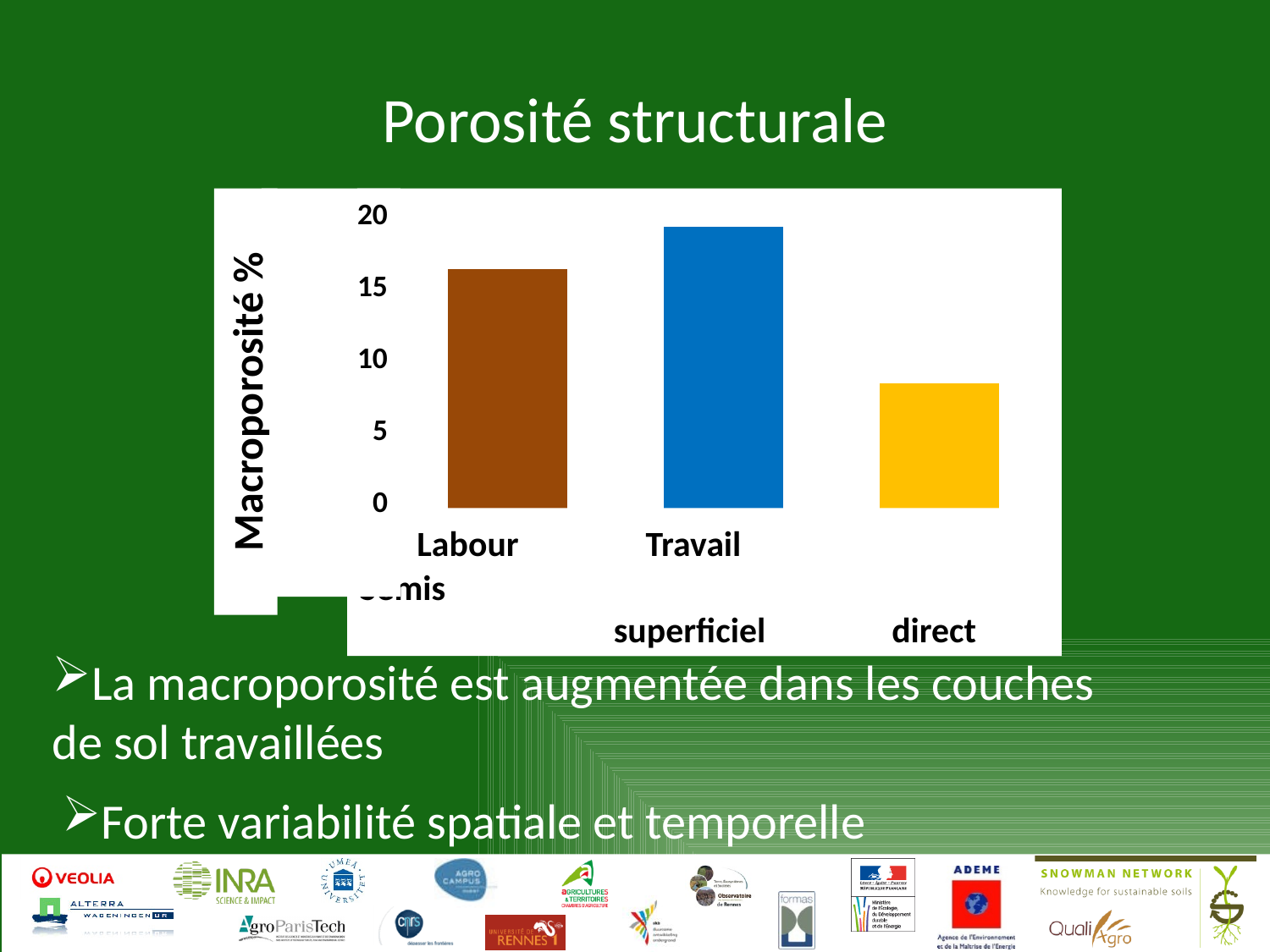
What is the highest value shown on the vertical axis? 20 Which is larger, the value for Labour or the value for Travail superficiel? Travail superficiel Which category has the highest macroporosity? Travail superficiel What colour is the bar for Travail superficiel? blue Is the value for Semis direct greater or less than 10? less Is the value for Labour greater or less than 15? greater Which category has the lowest macroporosity? Semis direct What is the title of the chart's vertical axis? Macroporosité % Is the value for Travail superficiel greater or less than 20? less What kind of chart is shown on the slide? bar chart Which is larger, the value for Labour or the value for Semis direct? Labour How many bars (categories) does the chart show? 3